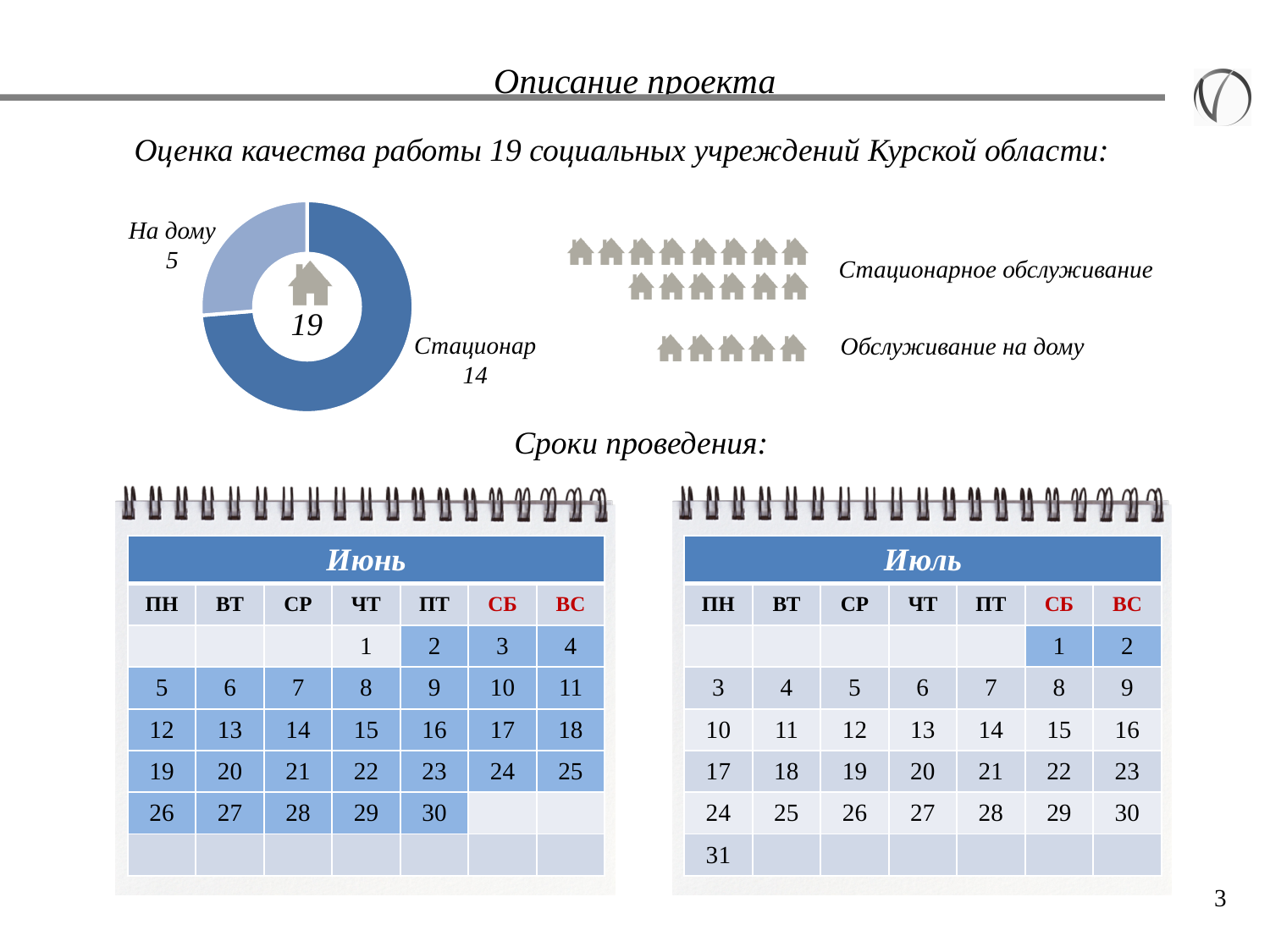
Which category has the largest slice in the doughnut chart? Стационар What is the difference between the values for Стационар and На дому in the doughnut chart? 9 Which category has the smallest slice in the doughnut chart? На дому How many house icons are shown next to the label Обслуживание на дому? 5 What is the value for На дому in the doughnut chart? 5 How many house icons are shown next to the label Стационарное обслуживание? 14 What is the total of the two slices in the doughnut chart? 19 What kind of chart is shown on the slide? doughnut chart What is the value for Стационар in the doughnut chart? 14 What number is printed in the centre of the doughnut chart? 19 How many categories does the doughnut chart show? 2 Which is larger in the doughnut chart, Стационар or На дому? Стационар